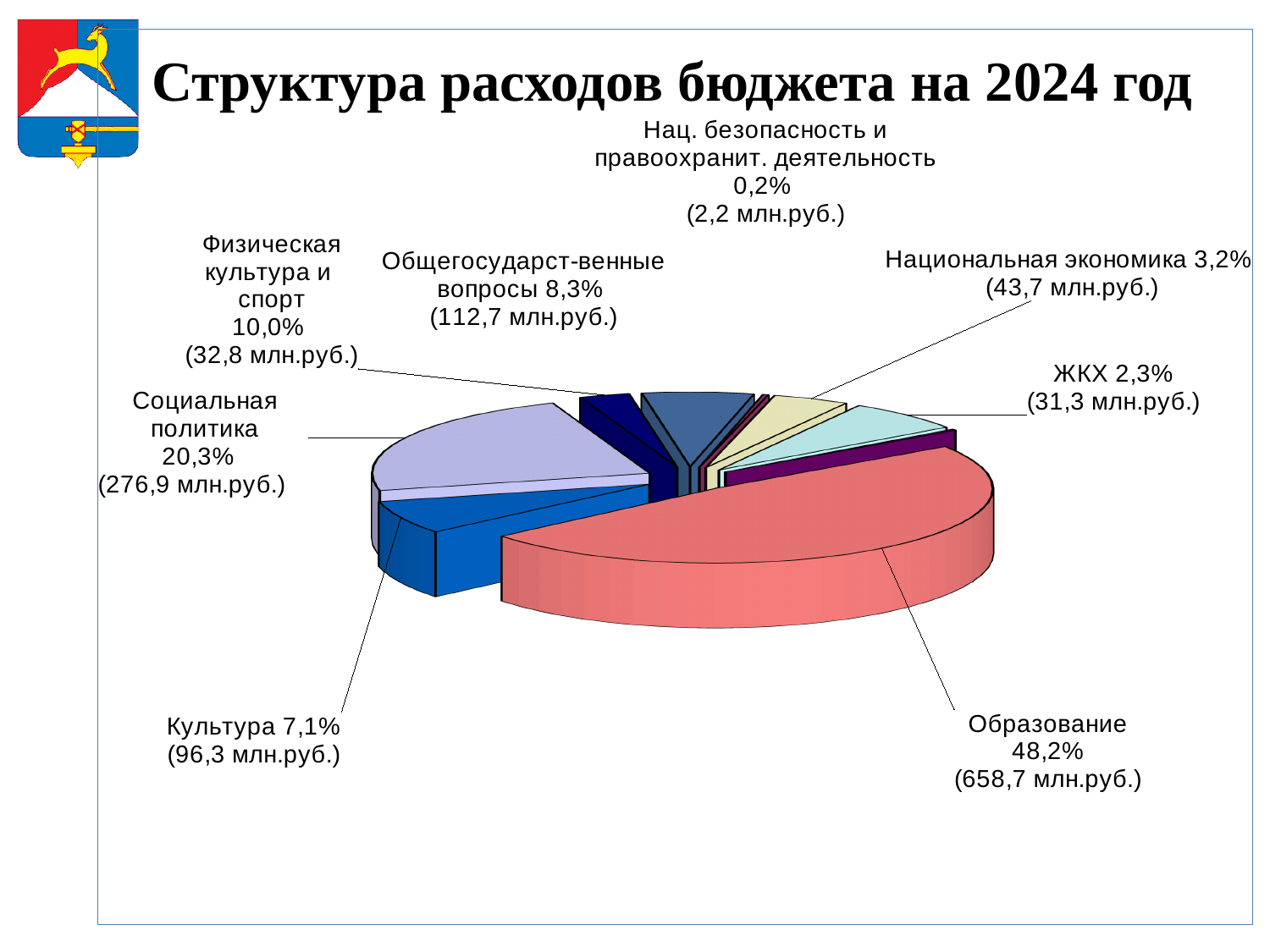
Какая сумма в млн.руб. указана для категории «Культура»? 96,3 млн.руб. Какова разница в млн.руб. между расходами на «Образование» и «Социальную политику»? 381,8 млн.руб. Какая сумма в млн.руб. указана для категории «Социальная политика»? 276,9 млн.руб. Какая категория больше по доле: «Национальная экономика» или «ЖКХ»? Национальная экономика Какова доля категории «Общегосударственные вопросы»? 8,3% На сколько процентных пунктов доля «Социальной политики» больше доли «Физической культуры и спорта»? 10,3 Какая категория имеет наибольшую долю расходов? Образование Какая категория имеет наименьшую долю расходов? Нац. безопасность и правоохранит. деятельность Какой тип диаграммы показан на слайде? круговая диаграмма Какова доля категории «Образование» в структуре расходов бюджета на 2024 год? 48,2% Как называется диаграмма на слайде? Структура расходов бюджета на 2024 год